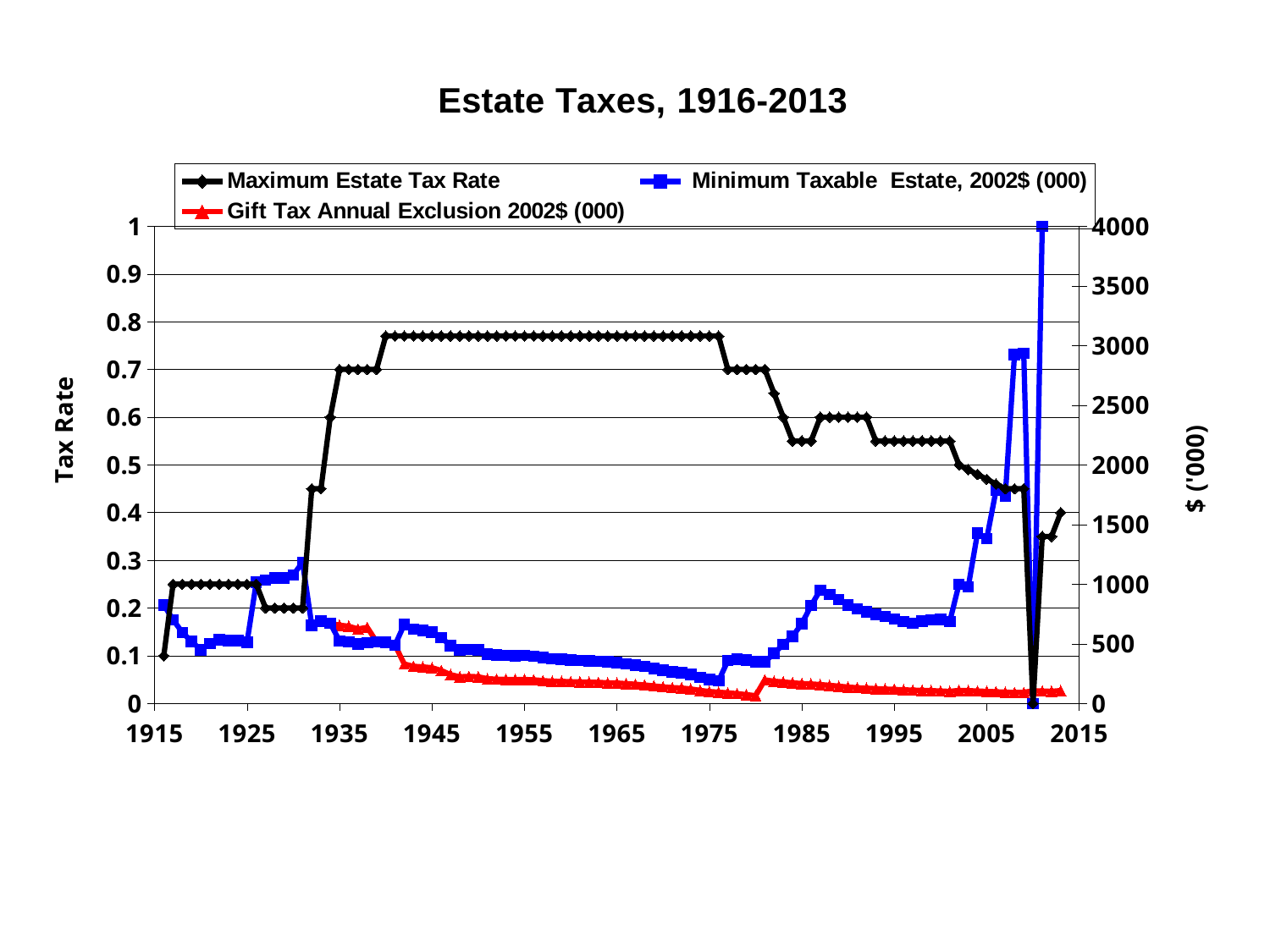
Is the Maximum Estate Tax Rate in 1960 greater or less than 0.7? greater Is the Gift Tax Annual Exclusion 2002$ (000) in 2000 greater or less than 500? less Is the Minimum Taxable Estate, 2002$ (000) in 1970 greater or less than 500? less Does the Minimum Taxable Estate, 2002$ (000) series generally rise or fall between 1945 and 1975? fall Which is larger, the Maximum Estate Tax Rate in 1960 or in 2000? 1960 In 1990, which is larger: the Minimum Taxable Estate, 2002$ (000) or the Gift Tax Annual Exclusion 2002$ (000)? Minimum Taxable Estate, 2002$ (000) How many series does the legend list? 3 What is the label of the right-hand vertical axis? $ ('000) What is the title of the chart? Estate Taxes, 1916-2013 What kind of chart is shown on the slide? line chart